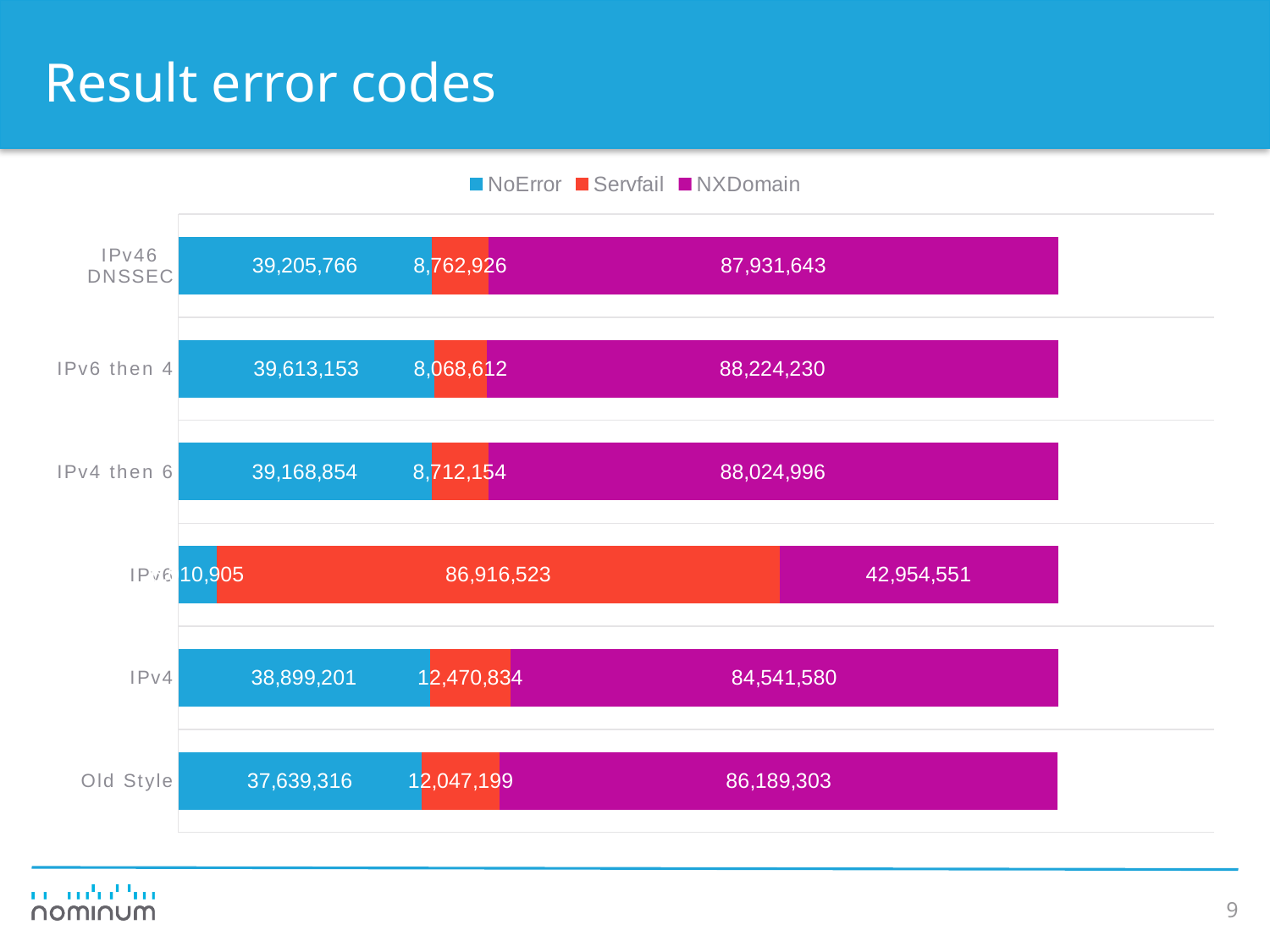
Which category has the lowest NoError value? IPv6 How many categories are shown on the chart? 6 How many series does the legend list? 3 Which category has the highest NXDomain value? IPv6 then 4 What kind of chart is shown on the slide? Stacked bar chart What is the Servfail value for IPv6? 86,916,523 What is the difference between the Servfail values for IPv4 and Old Style? 423,635 What is the NXDomain value for IPv46 DNSSEC? 87,931,643 Which category has the highest Servfail value? IPv6 What is the NoError value for Old Style? 37,639,316 What is the total of the three values in the Old Style bar? 135,875,818 Which has the larger NoError value, IPv6 then 4 or IPv46 DNSSEC? IPv6 then 4